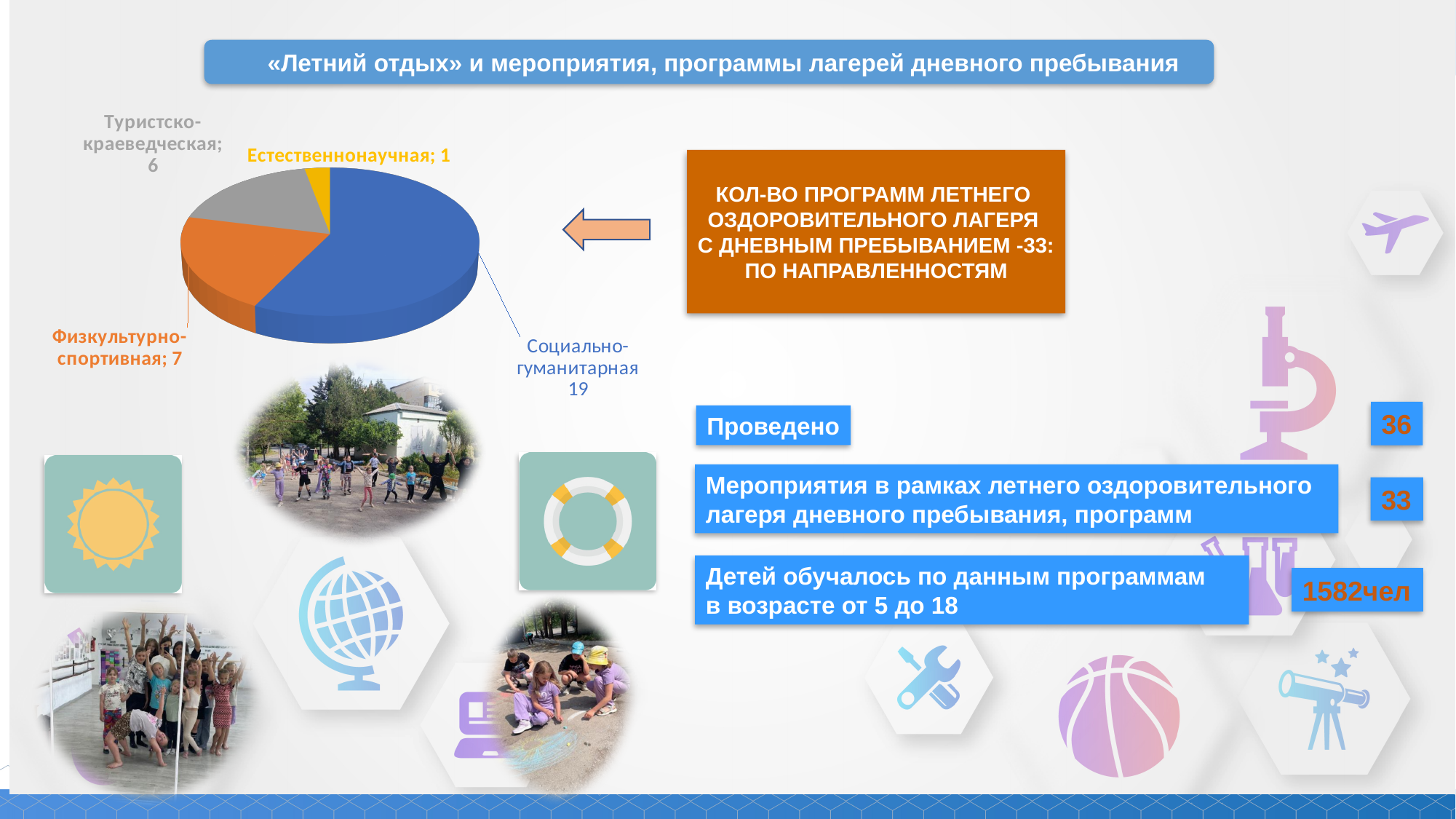
What kind of chart is shown on the slide? pie chart What is the value for Физкультурно-спортивная in the pie chart? 7 What is the difference between the values for Социально-гуманитарная and Физкультурно-спортивная? 12 Which is larger in the pie chart: Физкультурно-спортивная or Туристско-краеведческая? Физкультурно-спортивная Which category has the largest slice in the pie chart? Социально-гуманитарная What is the value for Естественнонаучная in the pie chart? 1 What is the value for Социально-гуманитарная in the pie chart? 19 What is the value for Туристско-краеведческая in the pie chart? 6 What is the total of all slices in the pie chart? 33 Which category has the smallest slice in the pie chart? Естественнонаучная What colour is the Социально-гуманитарная slice in the pie chart? blue How many slices does the pie chart have? 4